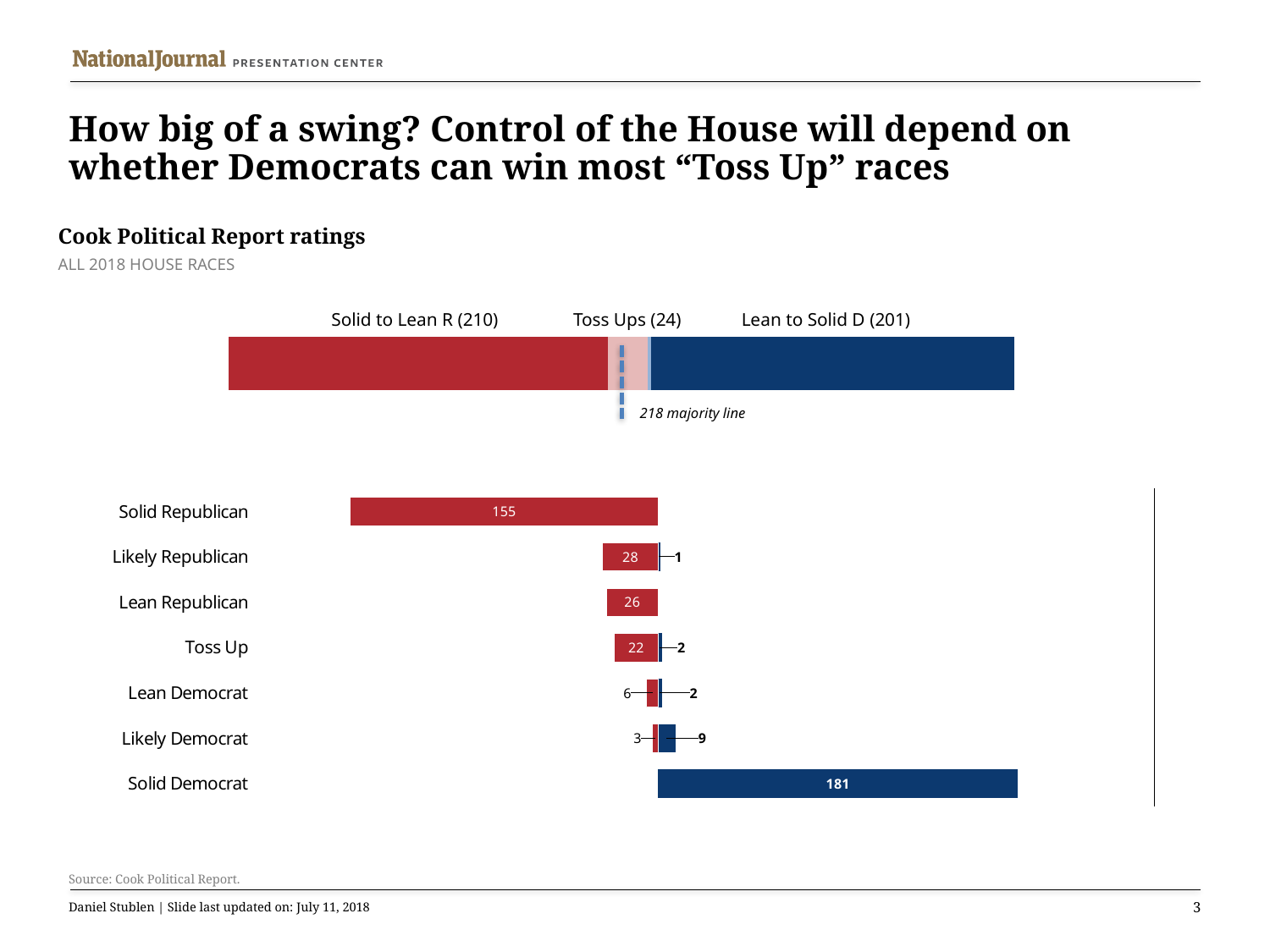
In the top stacked bar chart, how many races are labelled as Toss Ups? 24 In the bottom bar chart, what is the value for Solid Democrat? 181 In the bottom bar chart, what is the value for Solid Republican? 155 In the top stacked bar chart, what is the total of the three segments? 435 In the top stacked bar chart, what is the difference between Solid to Lean R and Lean to Solid D? 9 In the top stacked bar chart, what is the value for Solid to Lean R? 210 How many categories are shown in the bottom bar chart? 7 In the top stacked bar chart, which segment is the largest? Solid to Lean R In the top stacked bar chart, what does the dashed vertical line represent? 218 majority line In the bottom bar chart, what is the value of the blue segment for Likely Democrat? 9 In the top stacked bar chart, what is the value for Lean to Solid D? 201 In the bottom bar chart, which category has the longest bar? Solid Democrat